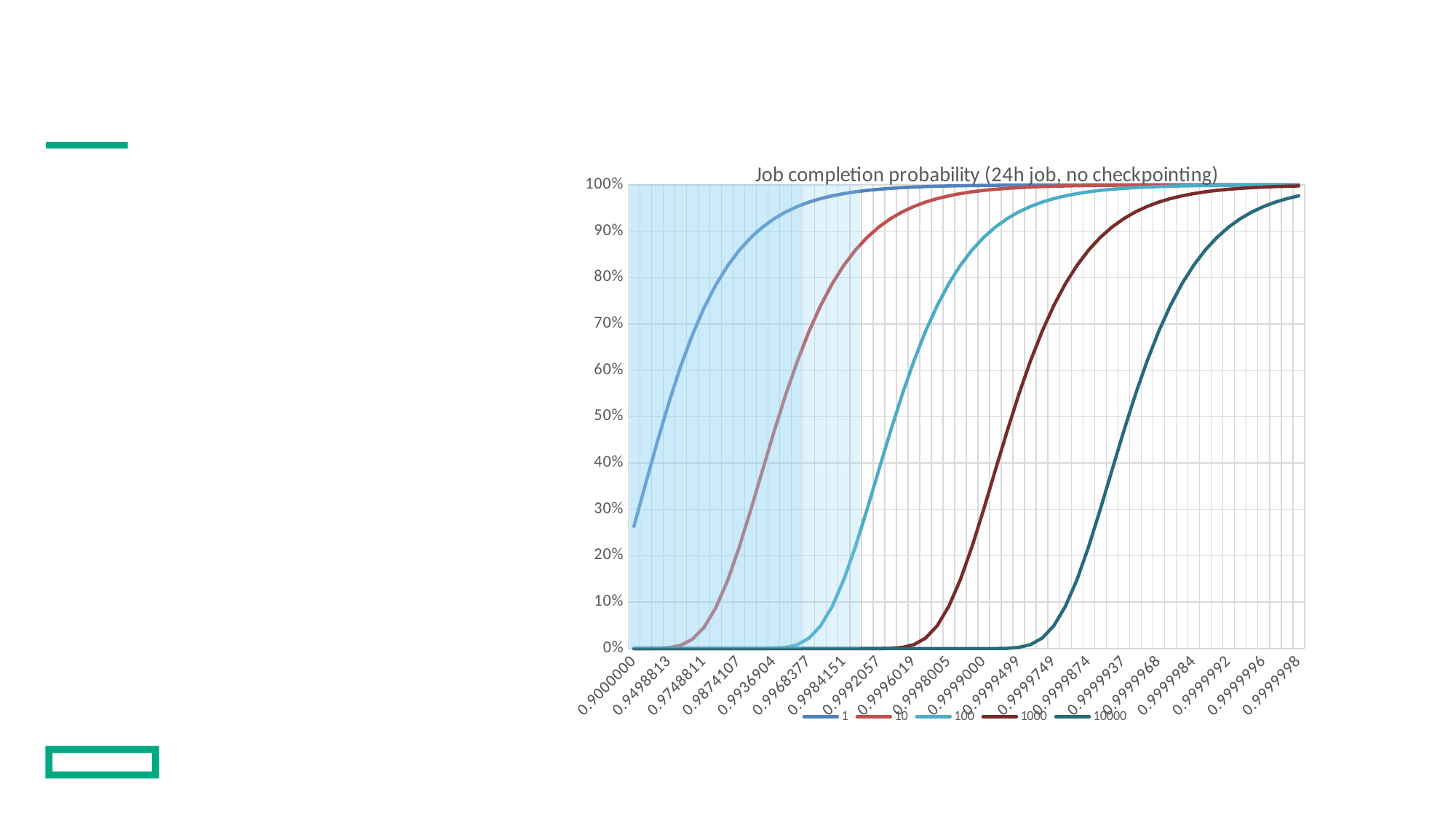
Is the value for series '1' at 0.9000000 greater or less than 30%? less Is the value for series '1' at 0.9748811 greater or less than 60%? greater Is the value for series '10000' at 0.9999998 greater or less than 90%? greater Which series reaches 50% at the largest x-axis value? 10000 At 0.9996019, which series has the larger value, '1' or '10000'? 1 How many series does the legend list? 5 Which series are listed in the legend? 1, 10, 100, 1000, 10000 Do the values of the series '1' rise or fall as you move along the x axis? rise How many labelled points are there along the x axis? 20 What kind of chart is shown on the slide? line chart What is the title of the chart? Job completion probability (24h job, no checkpointing)